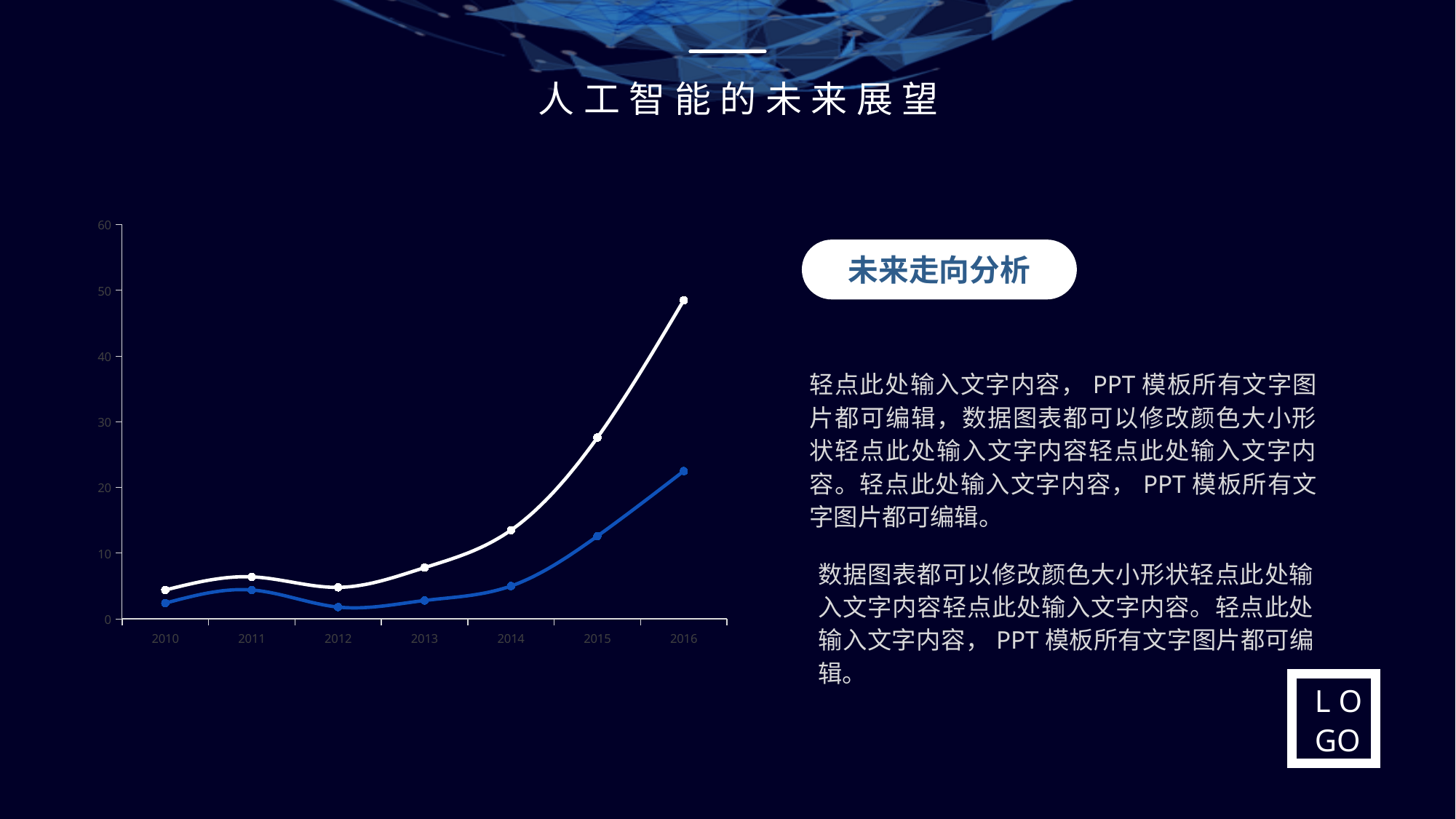
Is the value of the blue line in 2016 greater or less than 30? less Do the values of the white line rise or fall overall from 2010 to 2016? rise Is the value of the white line in 2015 greater or less than 20? greater In which year does the white line reach its highest value? 2016 In 2016, which line has the higher value, the white line or the blue line? the white line How many years are plotted along the x axis of the chart? 7 Is the value of the blue line in 2010 greater or less than 10? less How many lines are plotted on the chart? 2 What kind of chart is shown on the slide? line chart What is the first year and the last year shown on the x axis of the chart? 2010 and 2016